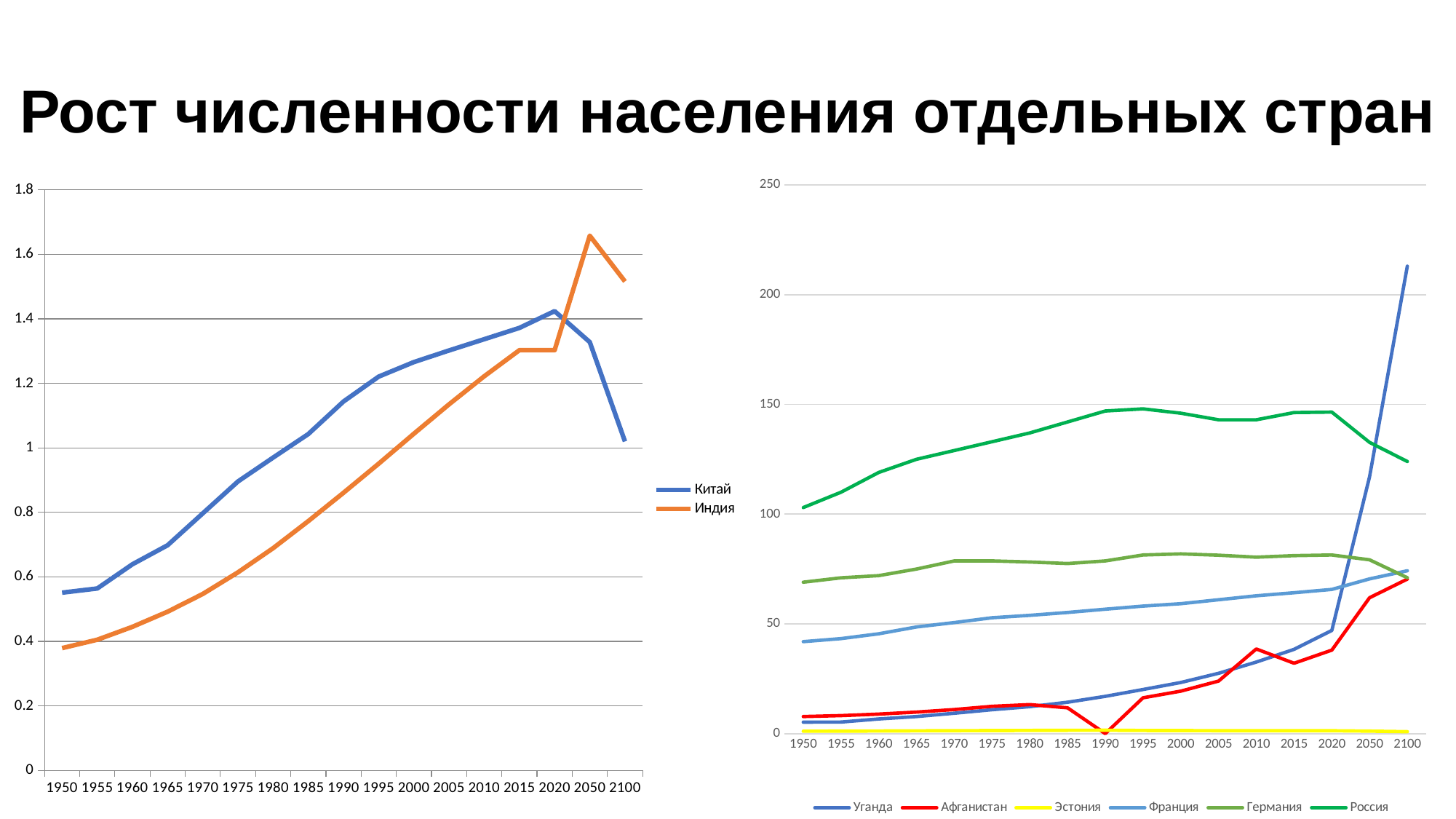
On the left chart, is the value for Китай in 1950 greater or less than 0.6? less On the left chart, is the value for Индия in 2050 greater or less than 1.6? greater How many series does the legend of the right chart list? 6 On the right chart, which series has the lowest value in 2020? Эстония On the right chart, does the value for Франция rise or fall from 1950 to 2100? rise On the left chart, which series has the higher value in 1950, Китай or Индия? Китай On the left chart, does the value for Китай rise or fall between 2020 and 2100? fall On the right chart, which series has the highest value in 2100? Уганда How many series does the legend of the left chart list? 2 What kind of chart is the left chart? line chart On the left chart, which series has the higher value in 2100, Китай or Индия? Индия On the right chart, is the value for Уганда in 2100 greater or less than 200? greater